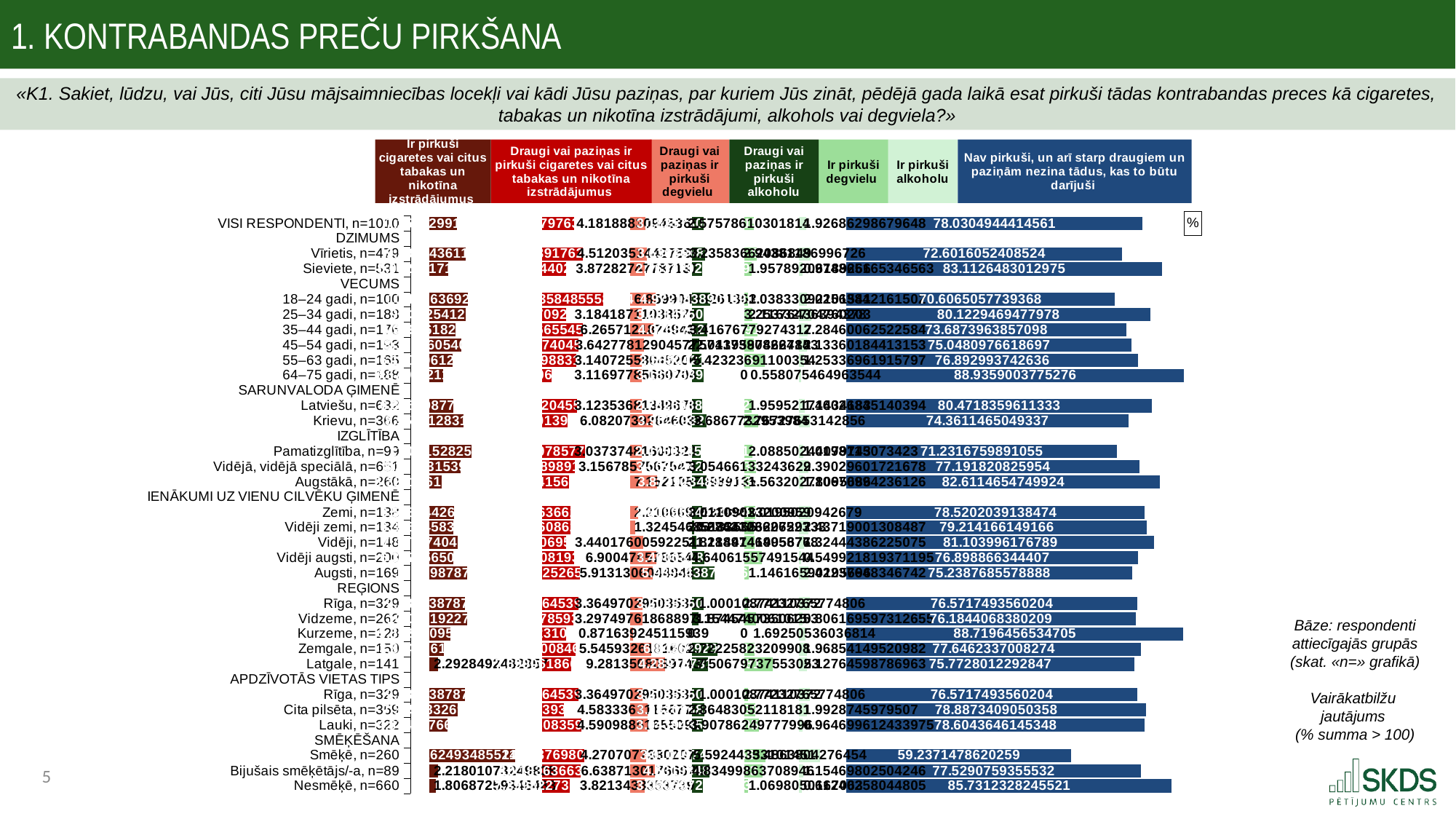
For the 'Nav pirkuši, un arī starp draugiem un paziņām nezina tādus, kas to būtu darījuši' series, which is larger: Vīrietis, n=479 or Sieviete, n=531? Sieviete, n=531 Is the value of the 'Nav pirkuši, un arī starp draugiem un paziņām nezina tādus, kas to būtu darījuši' series for Nesmēķē, n=660 greater or less than 80? greater What is the value of the 'Nav pirkuši, un arī starp draugiem un paziņām nezina tādus, kas to būtu darījuši' series for Kurzeme, n=128? 88.7196456534705 What kind of chart is shown on the slide? bar chart What is the value of the 'Nav pirkuši, un arī starp draugiem un paziņām nezina tādus, kas to būtu darījuši' series for Smēķē, n=260? 59.2371478620259 How many series does the legend list? 7 What colour represents the 'Nav pirkuši, un arī starp draugiem un paziņām nezina tādus, kas to būtu darījuši' series? dark blue What is the value of the 'Nav pirkuši, un arī starp draugiem un paziņām nezina tādus, kas to būtu darījuši' series for Sieviete, n=531? 83.1126483012975 How many age-group categories are plotted under VECUMS? 6 Which category has the lowest value for the 'Nav pirkuši, un arī starp draugiem un paziņām nezina tādus, kas to būtu darījuši' series? Smēķē, n=260 What is the difference between Sieviete, n=531 and Vīrietis, n=479 for the 'Nav pirkuši, un arī starp draugiem un paziņām nezina tādus, kas to būtu darījuši' series? 10.5110430604451 What is the value of the 'Nav pirkuši, un arī starp draugiem un paziņām nezina tādus, kas to būtu darījuši' series for VISI RESPONDENTI, n=1010? 78.0304944414561